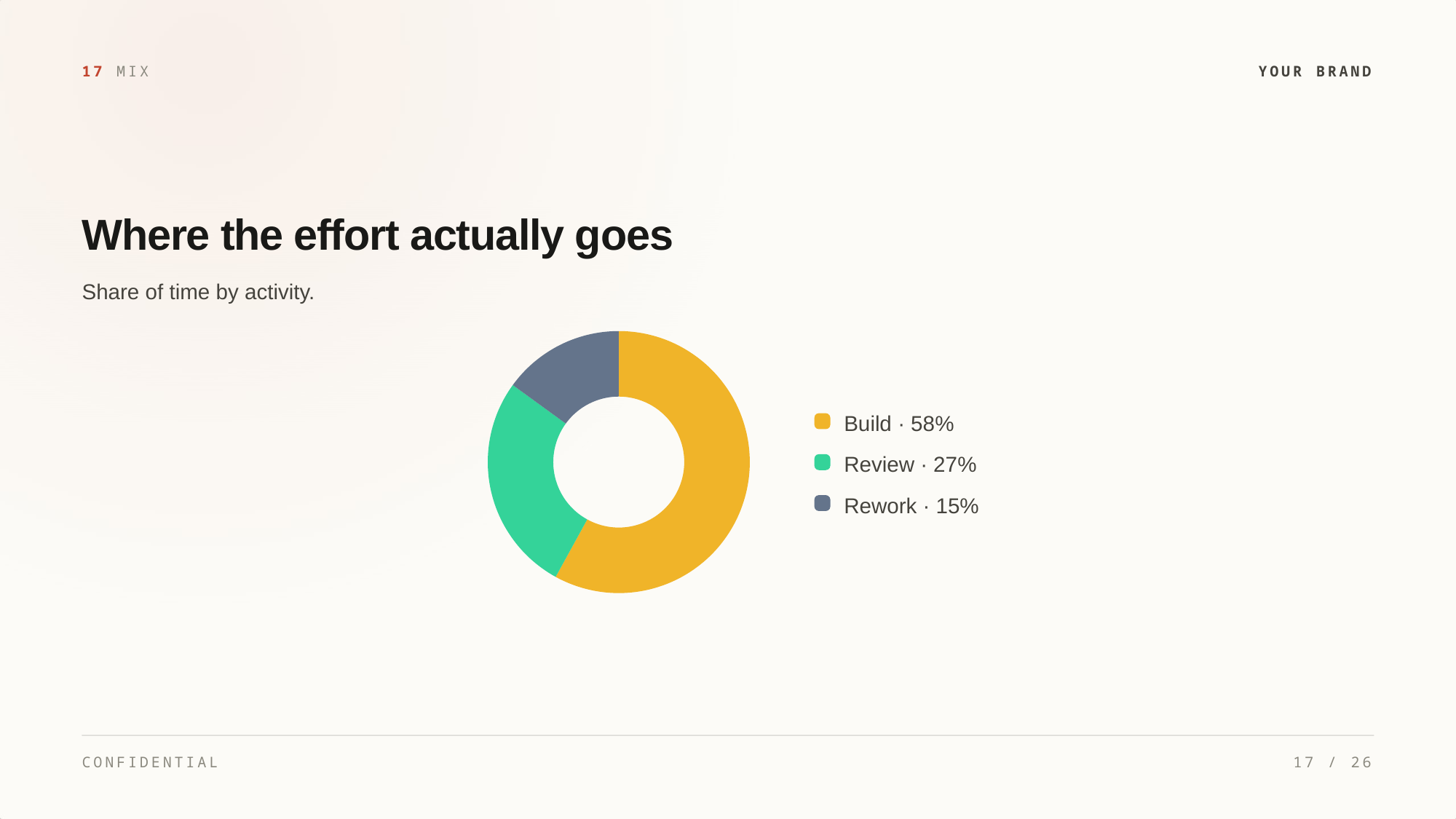
What is the difference in percentage points between Build and Review? 31 Which activity has the largest share of time? Build Which has a larger share of time, Review or Rework? Review What is the title of the slide containing the chart? Where the effort actually goes What colour represents Review in the chart? Green What share of time does Rework account for? 15% What share of time does Review account for? 27% What kind of chart is shown on the slide? Pie chart (donut) How many activities are shown in the chart? 3 Which activity has the smallest share of time? Rework What share of time does Build account for? 58% What is the difference in percentage points between Review and Rework? 12